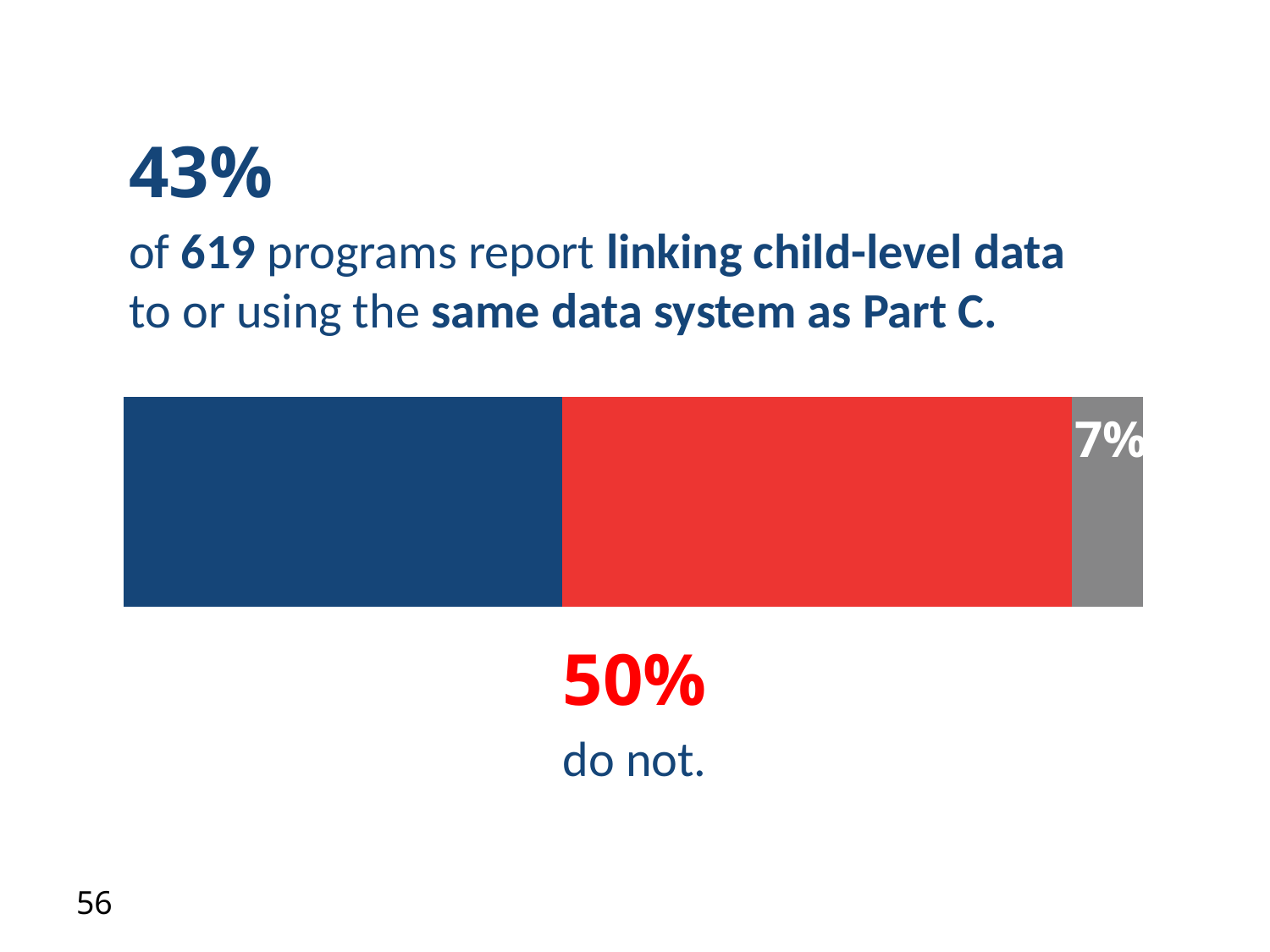
What is the difference between the red segment (50%) and the gray segment (7%)? 43 percentage points What value is printed on the gray segment of the bar? 7% Which segment of the bar is the smallest? the gray segment (7%) What colour is the segment representing programs that do not link child-level data? red Which segment of the bar is the largest? the red segment (50%) How many segments make up the stacked bar? 3 What kind of chart is shown on the slide? bar chart What percentage does the blue segment of the bar represent? 43% What percentage does the red segment of the bar represent? 50% Which is larger, the blue segment or the red segment? the red segment What is the difference between the red segment (50%) and the blue segment (43%)? 7 percentage points What is the total of all three segments of the bar? 100%